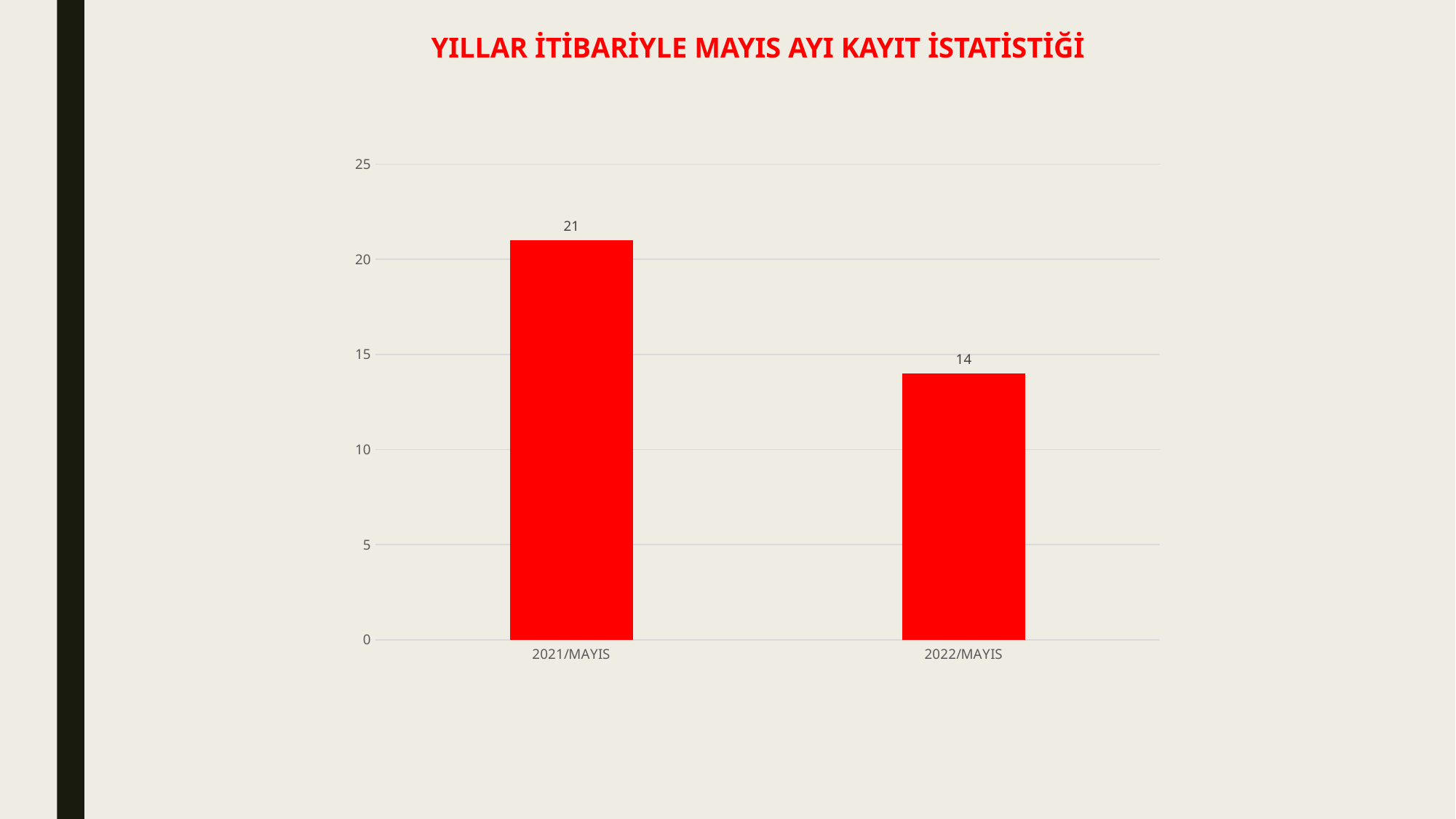
Is the value for 2021/MAYIS greater or less than 20? greater Do the values rise or fall from 2021/MAYIS to 2022/MAYIS? fall Which is larger, the value for 2021/MAYIS or the value for 2022/MAYIS? 2021/MAYIS Is the value for 2022/MAYIS greater or less than 15? less What kind of chart is shown on the slide? bar chart What is the difference between the values for 2021/MAYIS and 2022/MAYIS? 7 Which category has the highest value? 2021/MAYIS Which category has the lowest value? 2022/MAYIS How many categories are shown on the x axis? 2 What is the title of the chart? YILLAR İTİBARİYLE MAYIS AYI KAYIT İSTATİSTİĞİ What is the value for 2022/MAYIS? 14 What is the value for 2021/MAYIS? 21